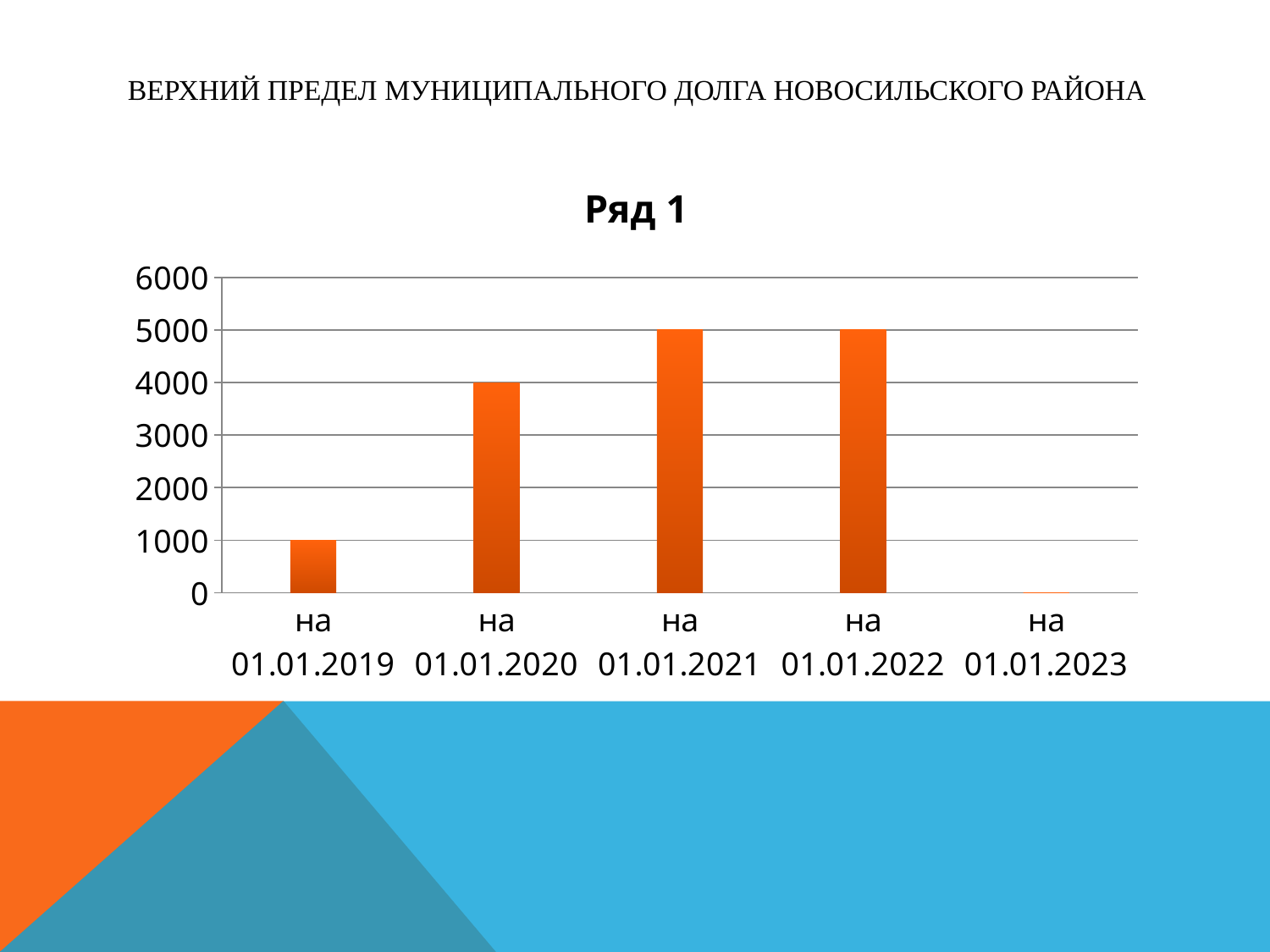
Which is larger, the value for на 01.01.2020 or the value for на 01.01.2019? на 01.01.2020 What is the difference between the values for на 01.01.2020 and на 01.01.2019? 3000 What is the value for на 01.01.2021? 5000 What is the value for на 01.01.2019? 1000 Is the value for на 01.01.2023 greater or less than 1000? less How many categories are shown on the x axis? 5 What type of chart is shown on the slide? Bar chart What is the value for на 01.01.2020? 4000 What is the difference between the values for на 01.01.2021 and на 01.01.2020? 1000 What is the value for на 01.01.2022? 5000 Which category has the lowest value? на 01.01.2023 What is the title shown above the chart? Ряд 1